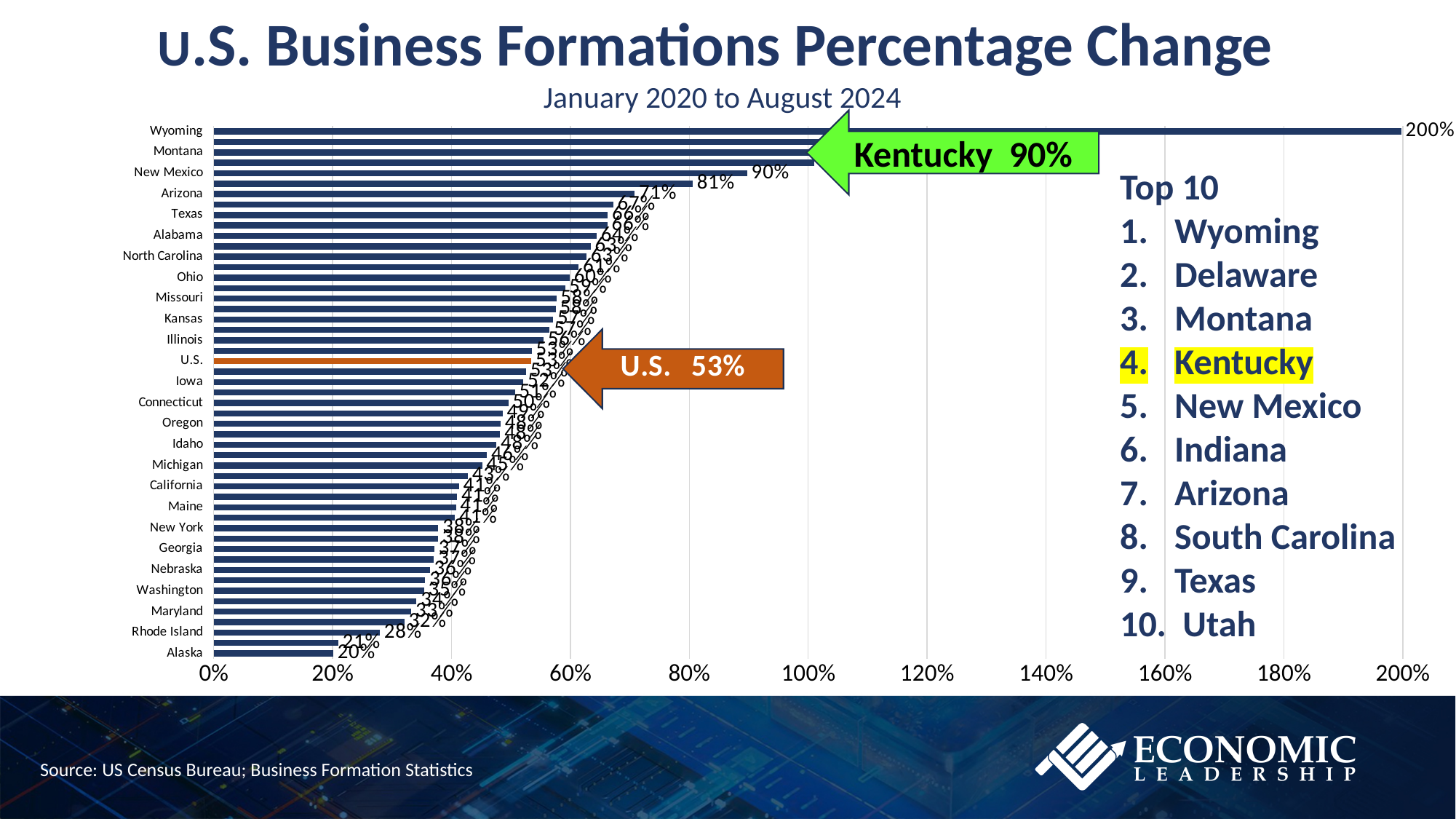
What is the difference between Wyoming's and Alaska's percentage change? 180% What is the percentage change for the U.S. overall? 53% What is the percentage change for Wyoming? 200% How much higher is Kentucky's percentage change than the U.S. value? 37% Which state has the highest business formations percentage change? Wyoming What kind of chart is shown on the slide? bar chart What is the percentage change for Alaska? 20% What is the percentage change for Kentucky? 90% Which state has the lowest business formations percentage change? Alaska Which state is ranked 4th in the Top 10 list on the slide? Kentucky Which has a larger percentage change, Wyoming or New Mexico? Wyoming Is the value for Maryland greater or less than 40%? less